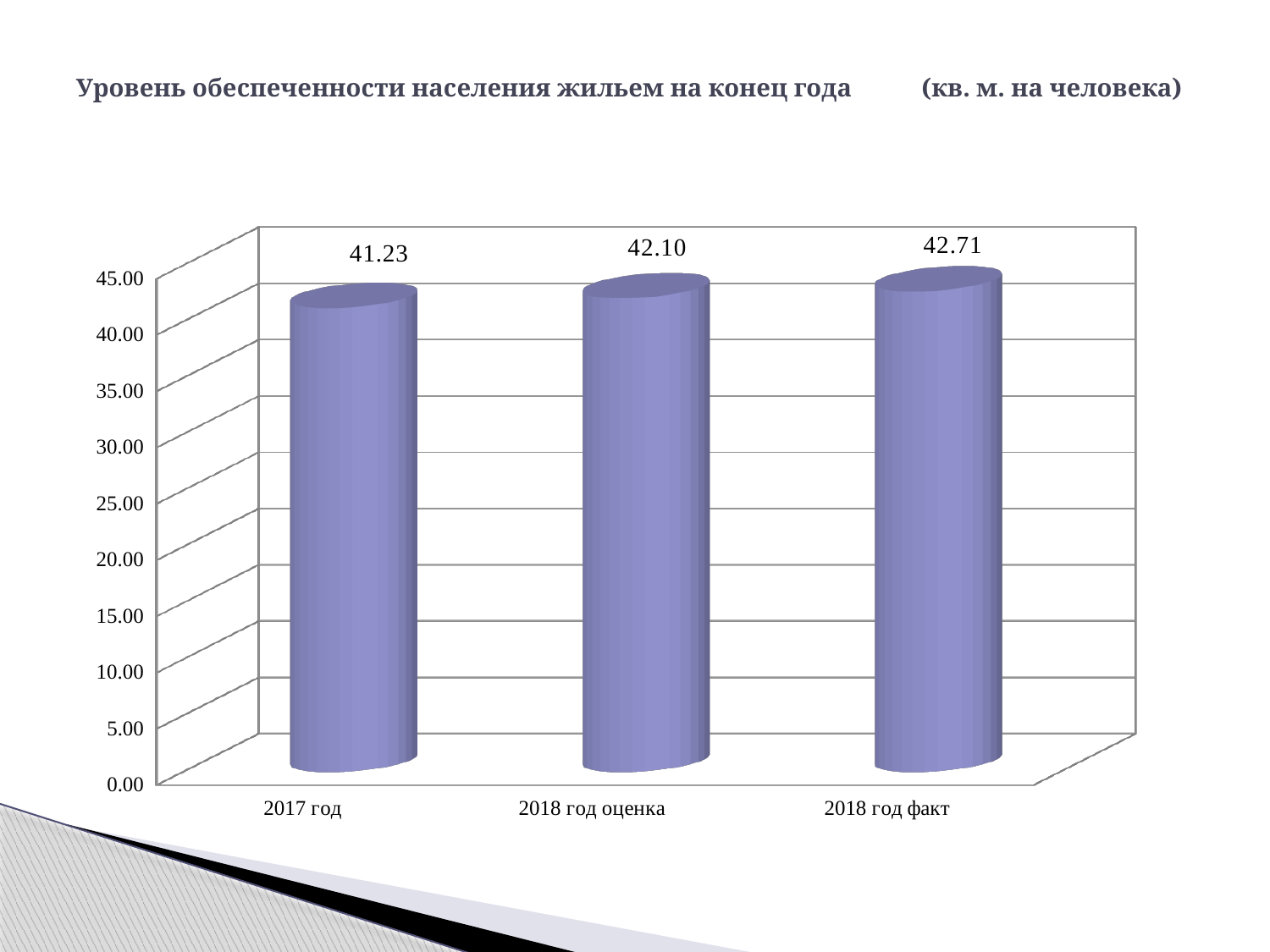
What is the value for 2018 год факт? 42.71 Which is larger, the value for 2018 год оценка or the value for 2017 год? 2018 год оценка Which category has the lowest value? 2017 год What is the difference between the values for 2018 год факт and 2017 год? 1.48 Which category has the highest value? 2018 год факт How many categories are shown on the x axis? 3 Do the values rise or fall from left to right along the x axis? rise What is the value for 2018 год оценка? 42.10 Is the value for 2017 год greater or less than 40.00? greater What kind of chart is shown on the slide? bar chart What is the difference between the values for 2018 год факт and 2018 год оценка? 0.61 What is the value for 2017 год? 41.23